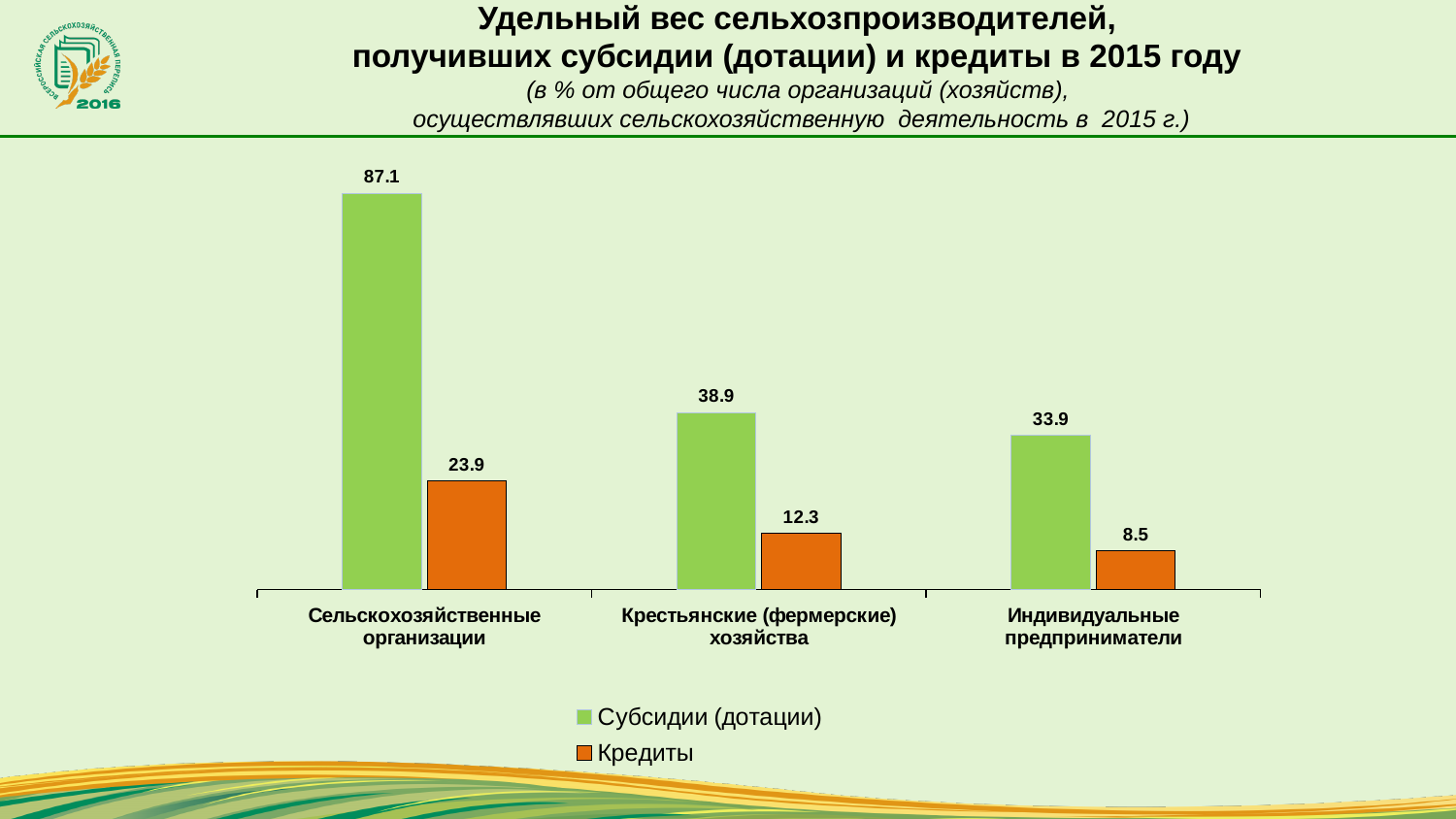
What is the difference between the Субсидии (дотации) values for Крестьянские (фермерские) хозяйства and Индивидуальные предприниматели? 5.0 Which is larger: the Кредиты value for Сельскохозяйственные организации or the Кредиты value for Крестьянские (фермерские) хозяйства? Сельскохозяйственные организации What kind of chart is shown on the slide? Bar chart What is the difference between the Субсидии (дотации) and Кредиты values for Сельскохозяйственные организации? 63.2 What is the value for Субсидии (дотации) for Сельскохозяйственные организации? 87.1 Which category has the highest value for Субсидии (дотации)? Сельскохозяйственные организации Which colour represents the Кредиты series? Orange What is the value for Кредиты for Крестьянские (фермерские) хозяйства? 12.3 What is the value for Кредиты for Индивидуальные предприниматели? 8.5 How many categories are shown on the x axis? 3 How many series does the legend list? 2 Which category has the lowest value for Кредиты? Индивидуальные предприниматели